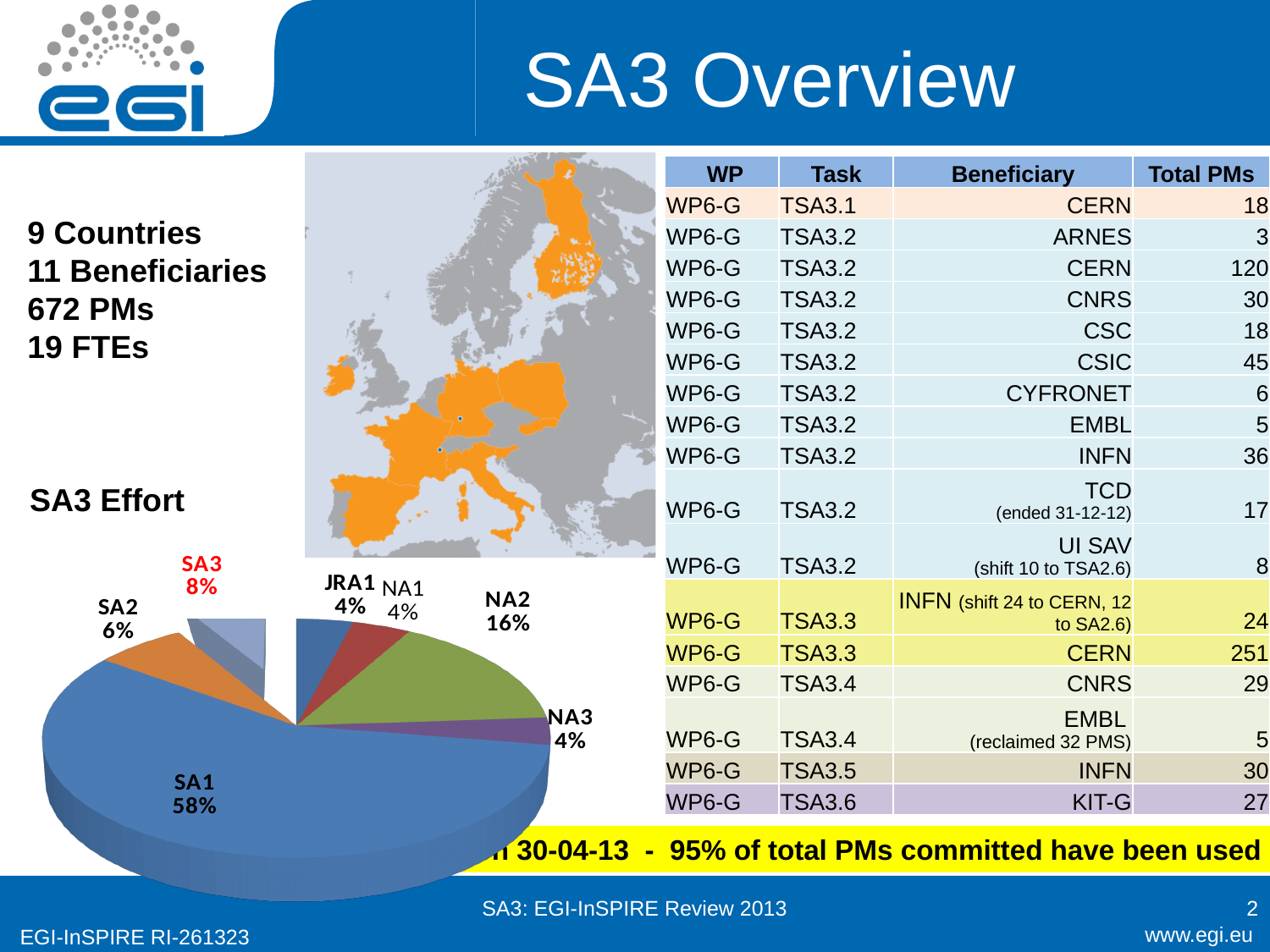
In the SA3 Effort pie chart, what share does SA2 have? 6% In the SA3 Effort pie chart, what is the difference between the SA3 share and the SA2 share? 2% In the SA3 Effort pie chart, which is larger, NA2 or SA3? NA2 In the SA3 Effort pie chart, which slice label is printed in red? SA3 What kind of chart is shown under the heading "SA3 Effort"? pie chart Which slice is the largest in the SA3 Effort pie chart? SA1 In the SA3 Effort pie chart, what is the difference between the SA1 share and the NA2 share? 42% In the SA3 Effort pie chart, what share does SA1 have? 58% In the SA3 Effort pie chart, what share does NA2 have? 16% How many slices does the SA3 Effort pie chart have? 7 In the SA3 Effort pie chart, what share does SA3 have? 8% In the SA3 Effort pie chart, what share does JRA1 have? 4%